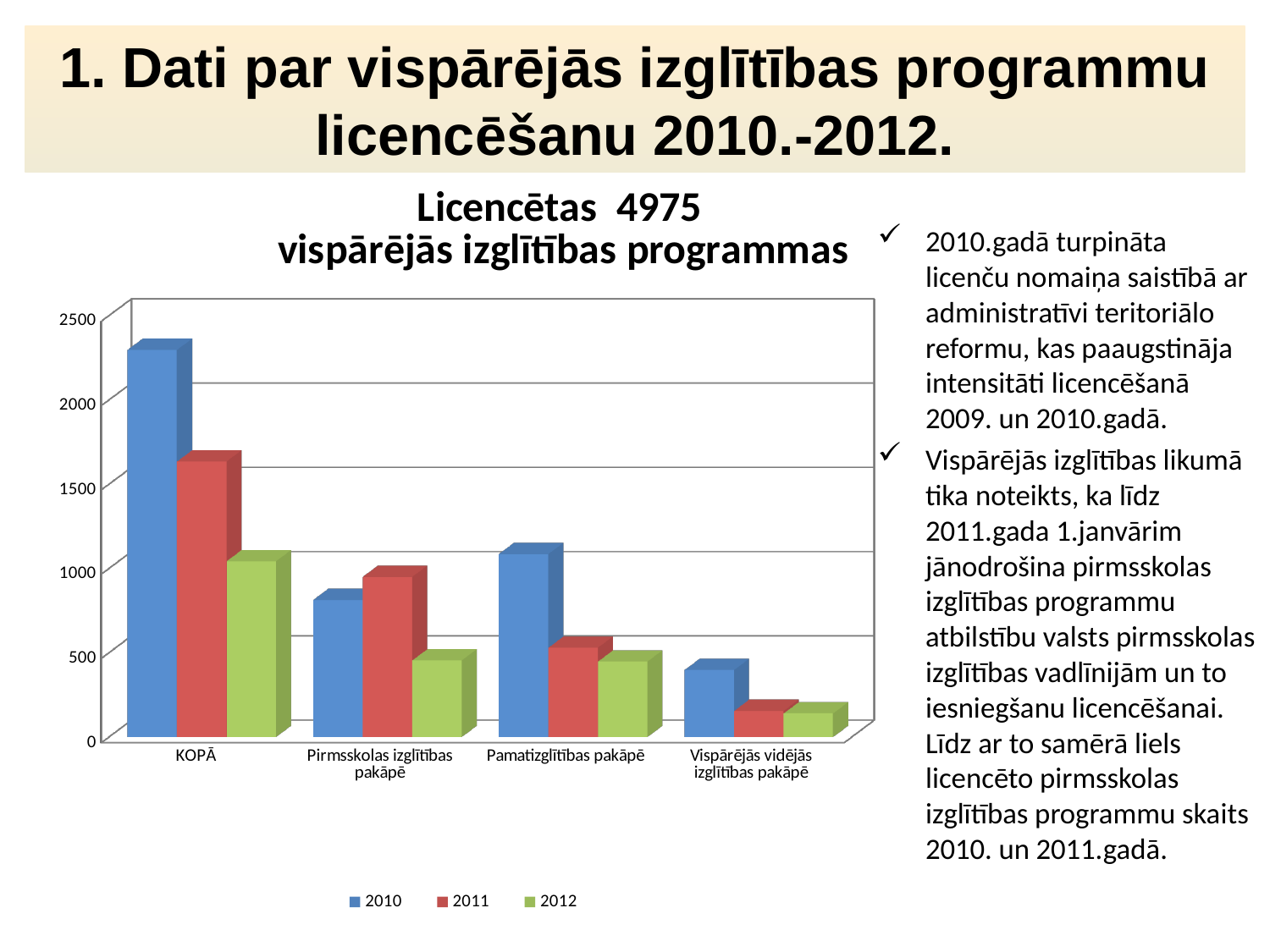
Which series has the highest value in the Pirmsskolas izglītības pakāpē category? 2011 Which category has the lowest values across all three series? Vispārējās vidējās izglītības pakāpē What kind of chart is shown on the slide? bar chart What is the title of the chart? Licencētas 4975 vispārējās izglītības programmas Is the value for 2010 in the KOPĀ category greater or less than 2000? greater Which series are listed in the chart legend? 2010, 2011, 2012 Is the value for 2012 in the Pirmsskolas izglītības pakāpē category greater or less than 500? less In the Pamatizglītības pakāpē category, which is larger: the value for 2010 or the value for 2011? 2010 How many categories are shown on the x axis of the chart? 4 Is the value for 2011 in the KOPĀ category greater or less than 1500? greater How many series does the chart legend list? 3